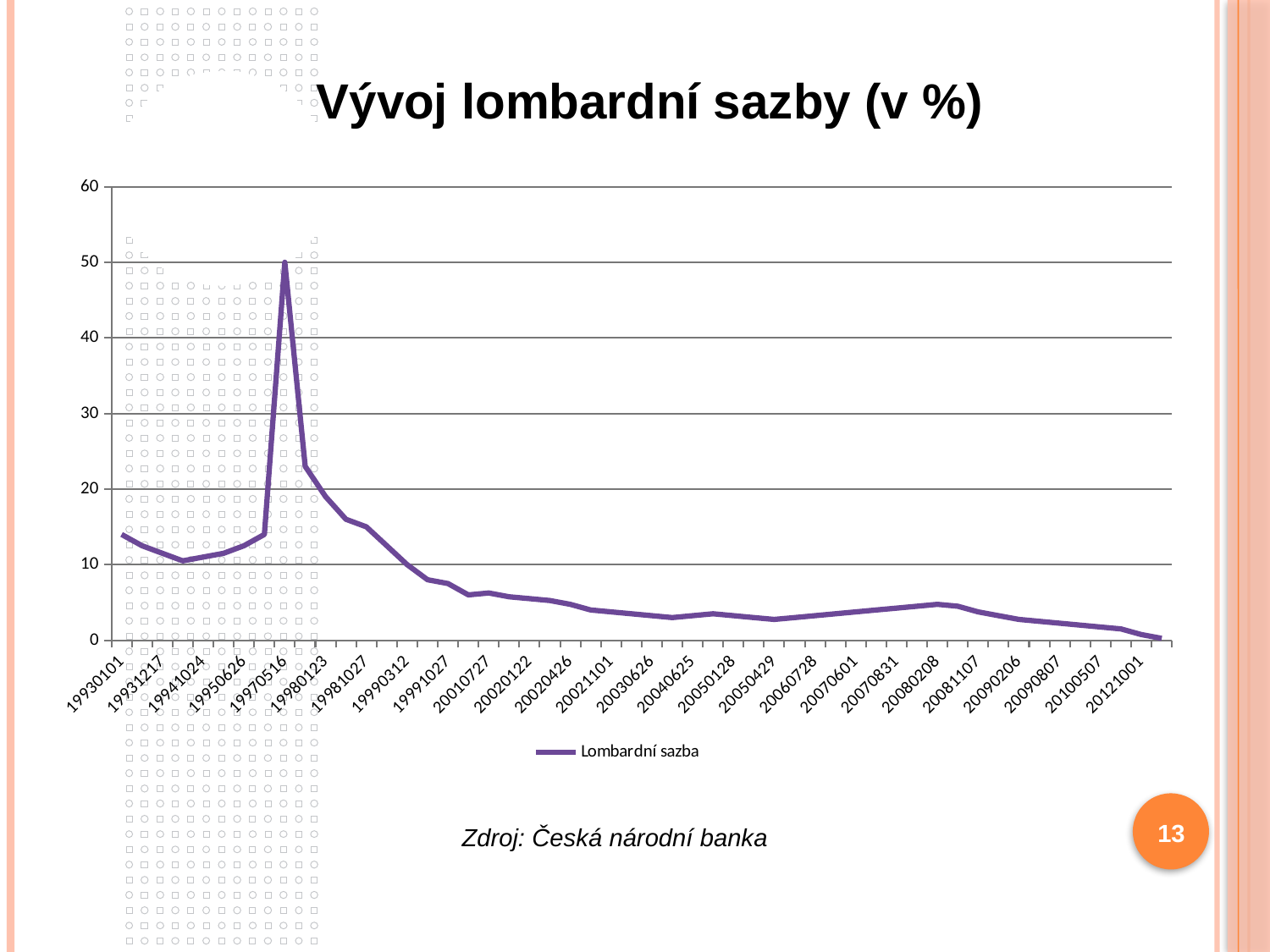
Is the value for 19970516 greater or less than 40? greater What kind of chart is shown on the slide? line chart At which date on the x axis does the Lombardní sazba reach its highest value? 19970516 What is the title of the chart? Vývoj lombardní sazby (v %) Is the value for 20121001 greater or less than 10? less What is the name of the series shown in the legend? Lombardní sazba How many series does the legend list? 1 Is the value for 19930101 greater or less than 10? greater From 19980123 to 20121001, do the values generally rise or fall? fall Which has the larger value, 19980123 or 19981027? 19980123